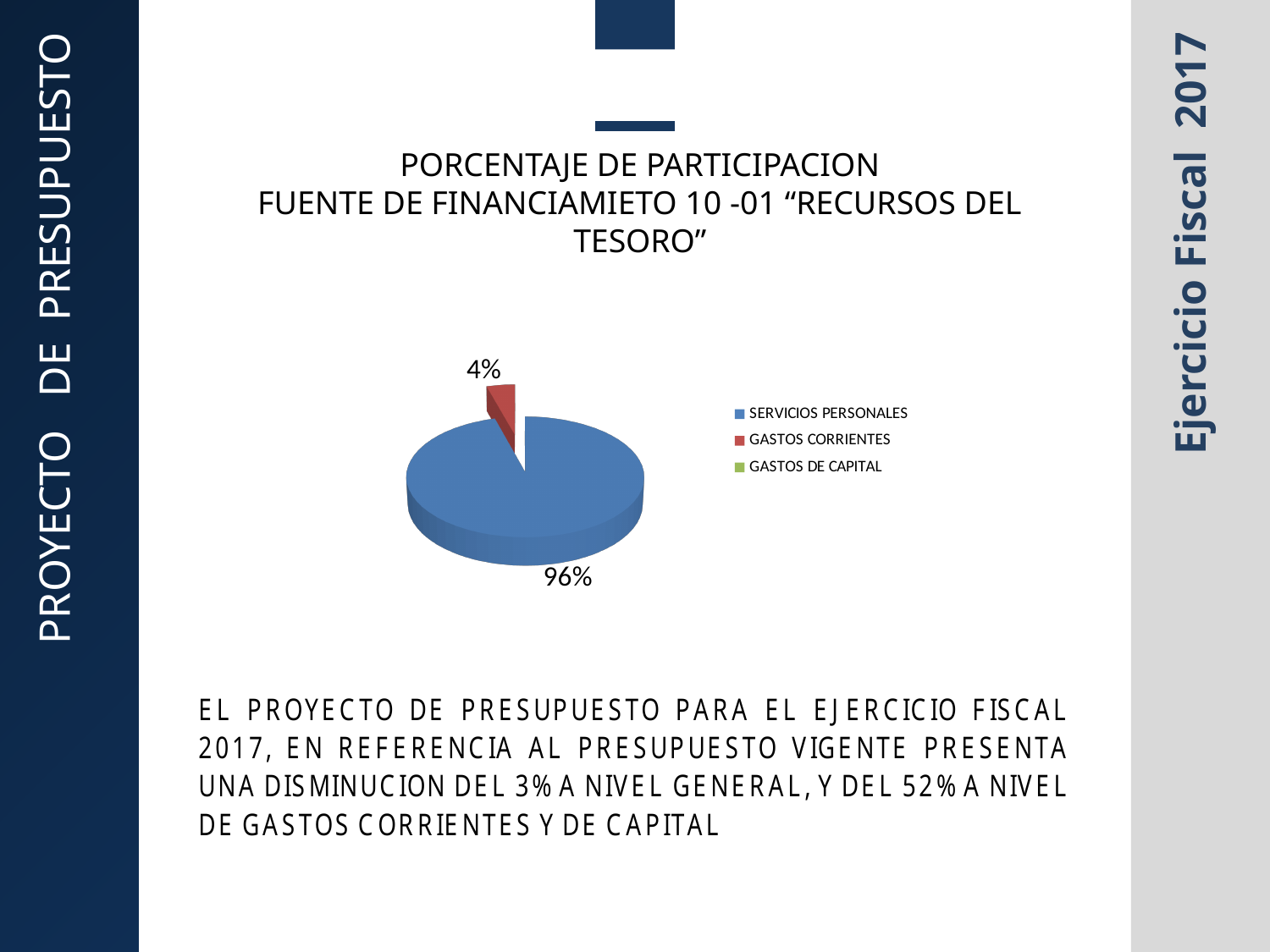
What percentage share does GASTOS CORRIENTES have in the pie chart? 4% What colour is the GASTOS CORRIENTES slice in the pie chart? Red How many slices with a printed percentage label are visible in the pie chart? 2 How many entries does the legend of the pie chart list? 3 Is the share for SERVICIOS PERSONALES greater or less than 50%? greater What kind of chart is shown on the slide? Pie chart Which category has the largest slice of the pie chart? SERVICIOS PERSONALES Which is larger in the pie chart, SERVICIOS PERSONALES or GASTOS CORRIENTES? SERVICIOS PERSONALES By how many percentage points does the SERVICIOS PERSONALES slice exceed the GASTOS CORRIENTES slice? 92 percentage points Which legend entry is shown in green in the pie chart? GASTOS DE CAPITAL What percentage share does SERVICIOS PERSONALES have in the pie chart? 96%